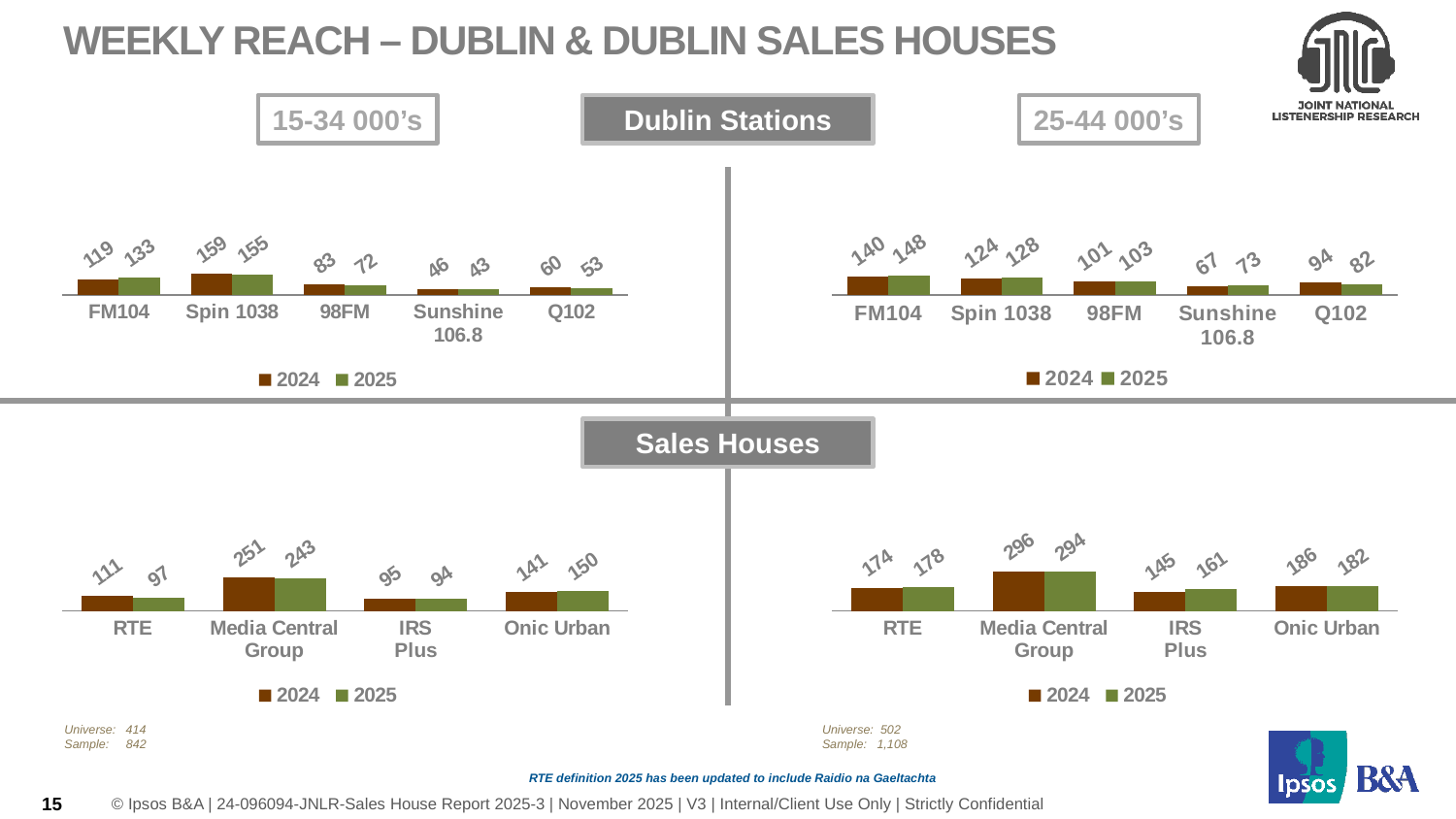
In the top-left Dublin Stations chart (15-34 000's), what is the 2025 value for FM104? 133 In the top-left Dublin Stations chart (15-34 000's), which station has the lowest 2025 value? Sunshine 106.8 In the top-left Dublin Stations chart (15-34 000's), which station has the highest 2024 value? Spin 1038 In the top-right Dublin Stations chart (25-44 000's), is the 2024 value for 98FM larger or the 2025 value? 2025 In the top-right Dublin Stations chart (25-44 000's), what is the 2024 value for Q102? 94 How many series does the legend list in the top-left Dublin Stations chart (15-34 000's)? 2 How many categories are shown in the bottom-left Sales Houses chart (15-34 000's)? 4 In the bottom-left Sales Houses chart (15-34 000's), what is the 2025 value for Media Central Group? 243 In the bottom-right Sales Houses chart (25-44 000's), what is the 2025 value for IRS Plus? 161 In the top-right Dublin Stations chart (25-44 000's), what is the difference between the 2025 and 2024 values for FM104? 8 In the bottom-left Sales Houses chart (15-34 000's), what is the difference between the 2024 and 2025 values for RTE? 14 In the bottom-right Sales Houses chart (25-44 000's), which sales house has the highest 2024 value? Media Central Group